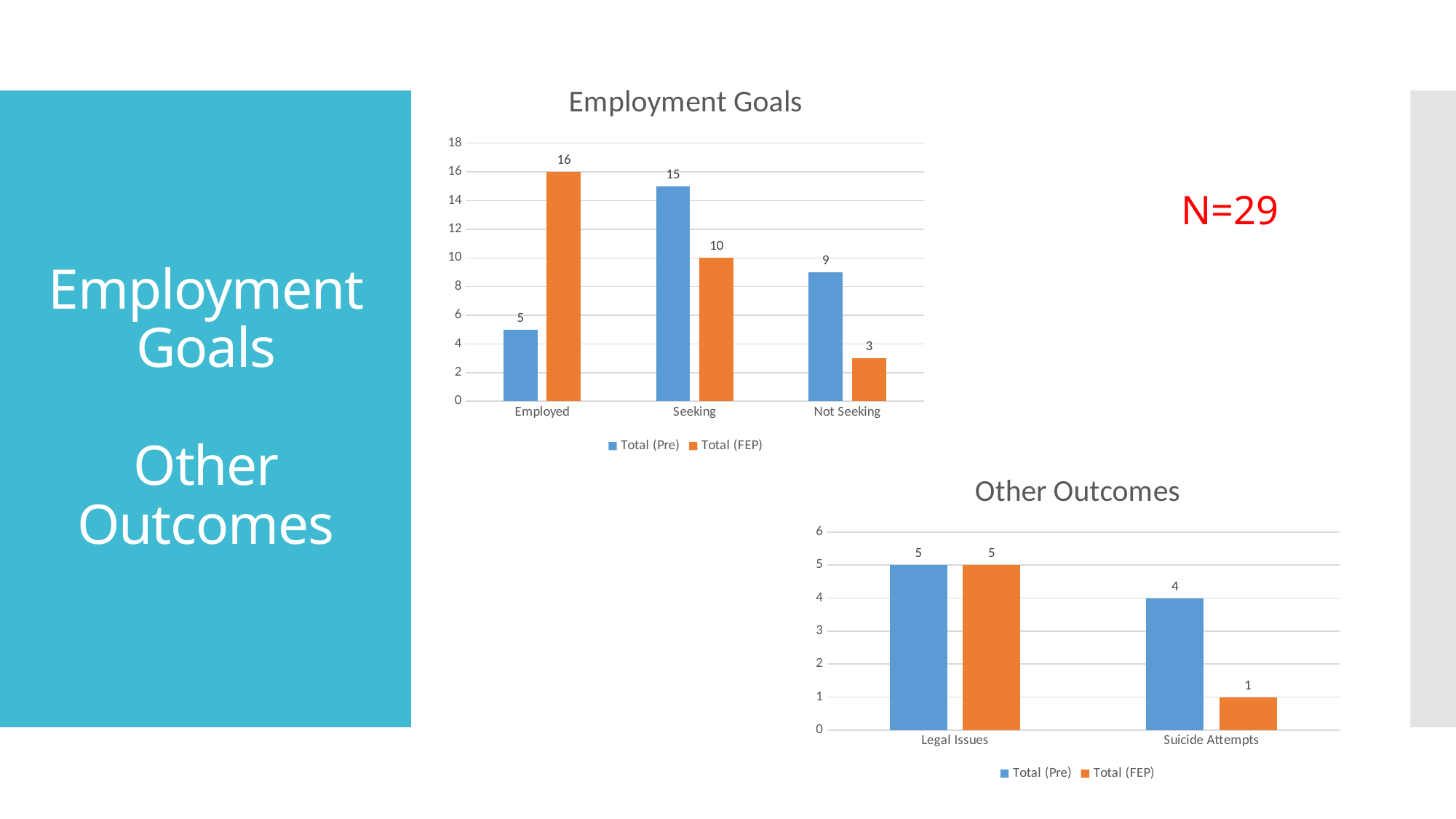
How many series does the legend of the Other Outcomes chart list? 2 In the Employment Goals chart, which is larger for Not Seeking: Total (Pre) or Total (FEP)? Total (Pre) In the Other Outcomes chart, what is the Total (FEP) value for Legal Issues? 5 In the Other Outcomes chart, what is the Total (Pre) value for Suicide Attempts? 4 In the Employment Goals chart, what is the difference between Total (FEP) and Total (Pre) for Employed? 11 In the Employment Goals chart, what is the Total (FEP) value for Employed? 16 In the Employment Goals chart, which category has the highest Total (Pre) value? Seeking In the Employment Goals chart, what is the Total (FEP) value for Not Seeking? 3 What type of chart is the Other Outcomes chart? Bar chart In the Other Outcomes chart, what is the difference between Total (Pre) and Total (FEP) for Suicide Attempts? 3 How many categories are shown in the Employment Goals chart? 3 In the Employment Goals chart, what is the Total (Pre) value for Seeking? 15